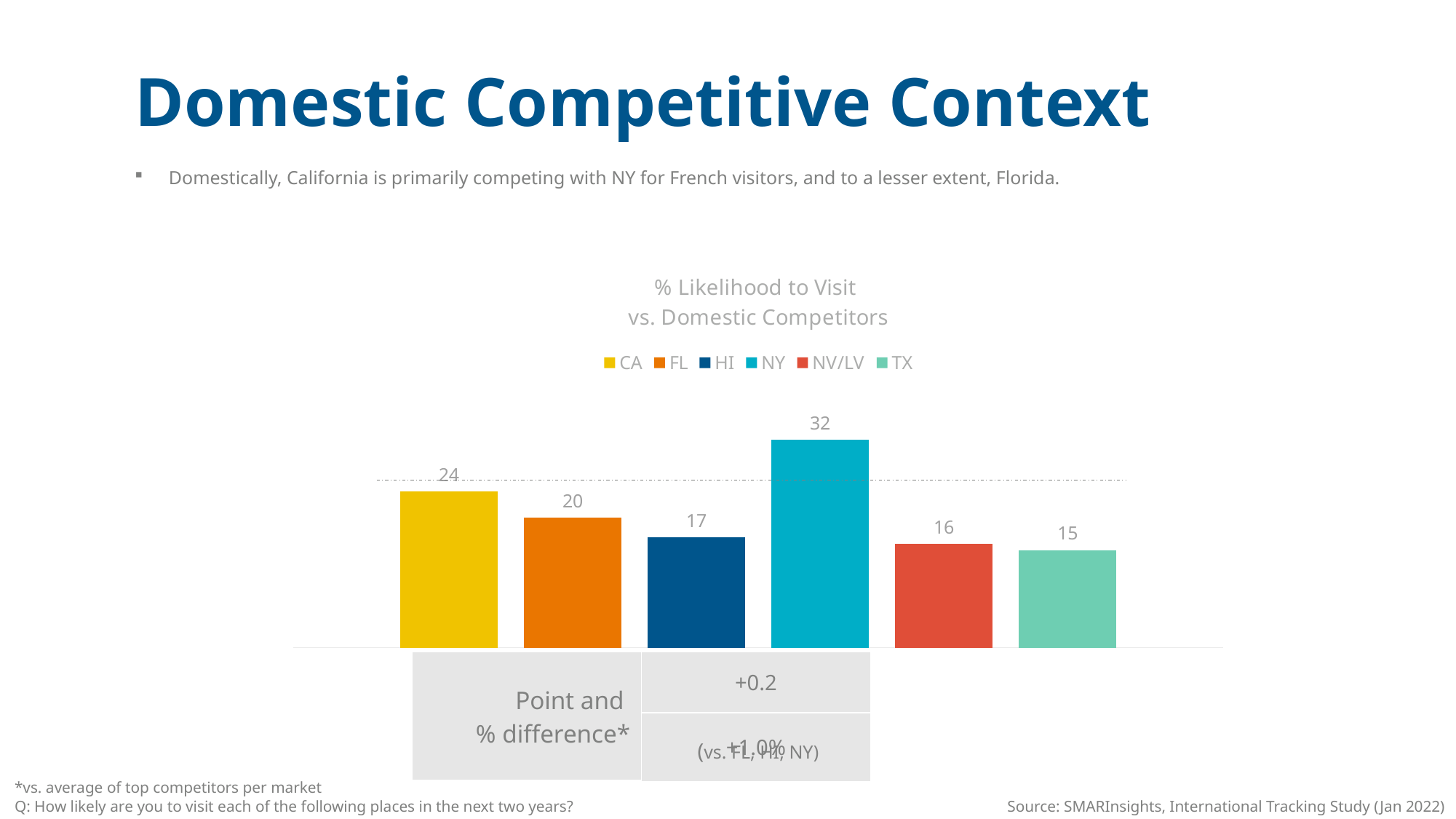
How many destinations are plotted in the chart? 6 Which has a larger value, HI or NV/LV? HI What type of chart is shown on the slide? Bar chart What is the difference between the values for CA and FL? 4 What is the % likelihood to visit value for NY? 32 What is the difference between the values for NY and CA? 8 Which destination has the lowest % likelihood to visit? TX What is the value shown for TX? 15 What is the % likelihood to visit value for CA? 24 What is the title of the chart? % Likelihood to Visit vs. Domestic Competitors What is the value shown for FL? 20 Which destination has the highest % likelihood to visit? NY